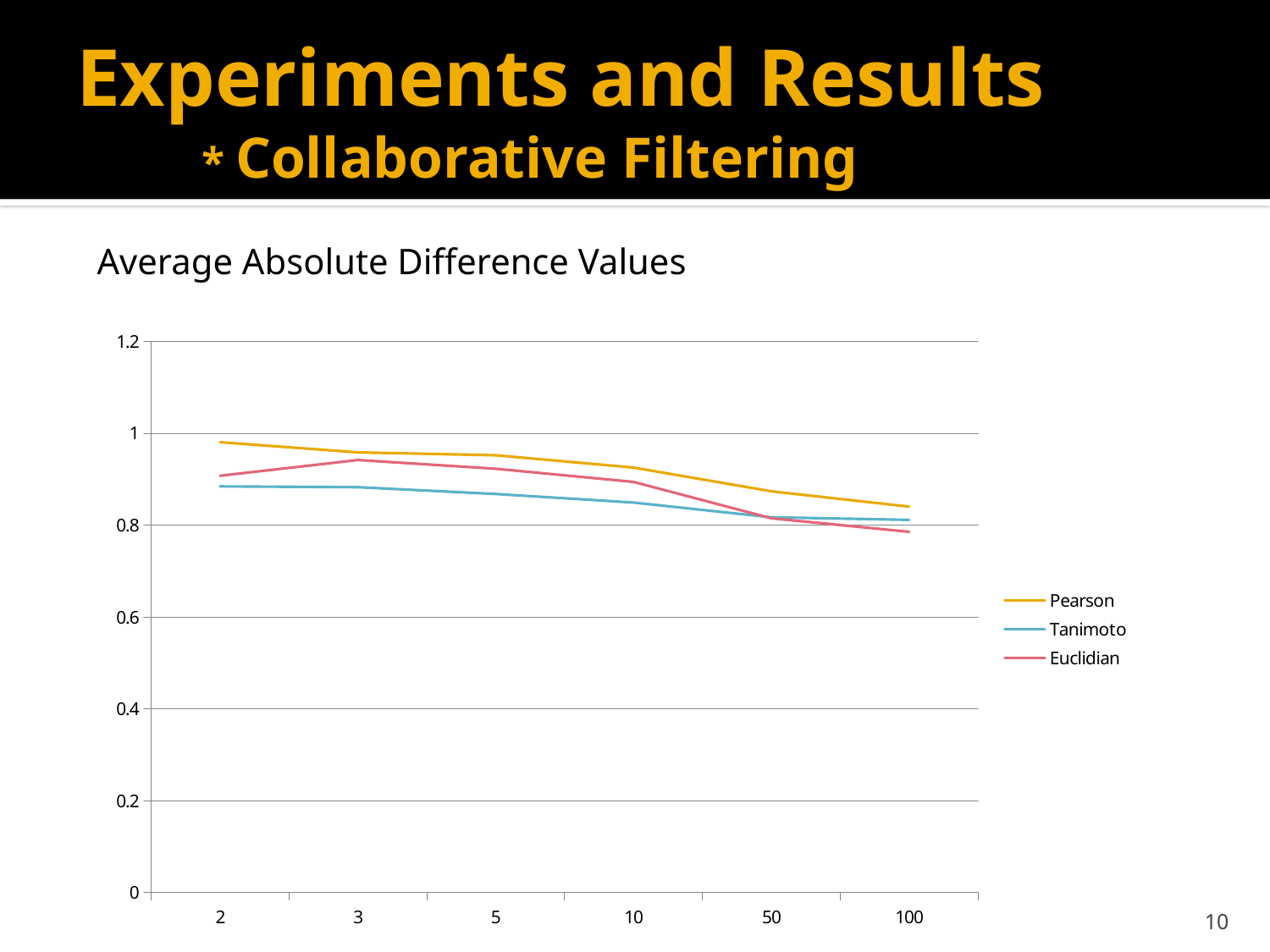
How many series does the legend list? 3 What is the title shown above the chart? Average Absolute Difference Values How many points are plotted along the x axis for each series? 6 Which series is drawn in blue? Tanimoto Is the Euclidian value at x = 100 greater or less than 0.8? less Which series has the lowest value at x = 100? Euclidian Is the Pearson value at x = 2 greater or less than 1? less Is the Tanimoto value at x = 100 greater or less than 0.8? greater Does the Pearson line rise or fall as x increases from 2 to 100? fall What kind of chart is shown on the slide? line chart At x = 2, which is larger: the Pearson value or the Tanimoto value? Pearson Which series has the highest value at x = 2? Pearson